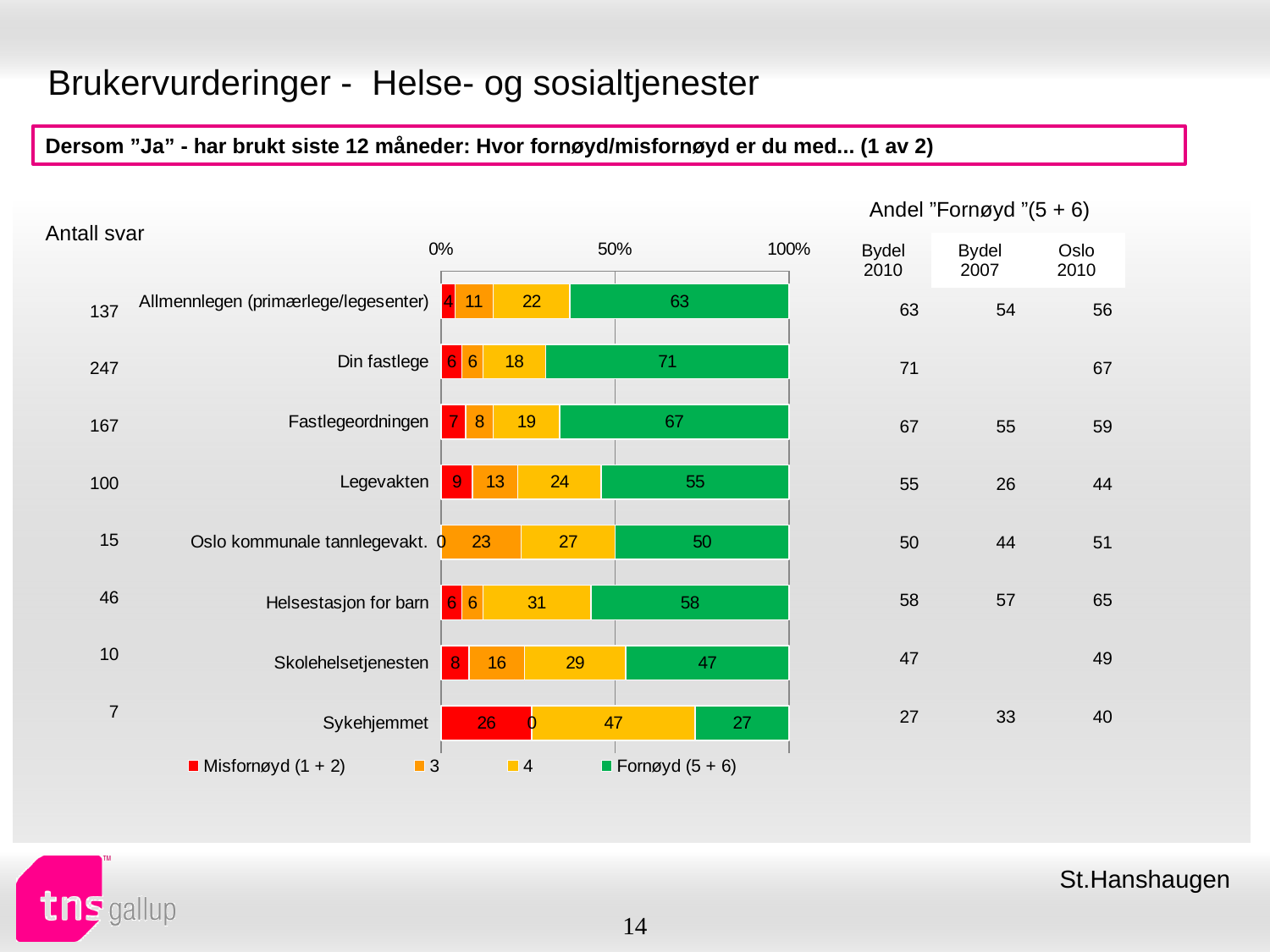
How many series does the legend list? 4 Which category has the lowest "Fornøyd (5 + 6)" value? Sykehjemmet What is the difference between the "Fornøyd (5 + 6)" values for Din fastlege and Allmennlegen (primærlege/legesenter)? 8 Which has a larger "Fornøyd (5 + 6)" value, Legevakten or Skolehelsetjenesten? Legevakten What is the value of the "3" segment for Oslo kommunale tannlegevakt.? 23 How many categories are shown in the chart? 8 What is the value of the "4" segment for Helsestasjon for barn? 31 What is the value of the "Fornøyd (5 + 6)" segment for Din fastlege? 71 What is the total of the stacked bar for Allmennlegen (primærlege/legesenter)? 100 What is the value of the "Misfornøyd (1 + 2)" segment for Sykehjemmet? 26 What kind of chart is shown on the slide? Stacked bar chart Which category has the highest "Fornøyd (5 + 6)" value? Din fastlege